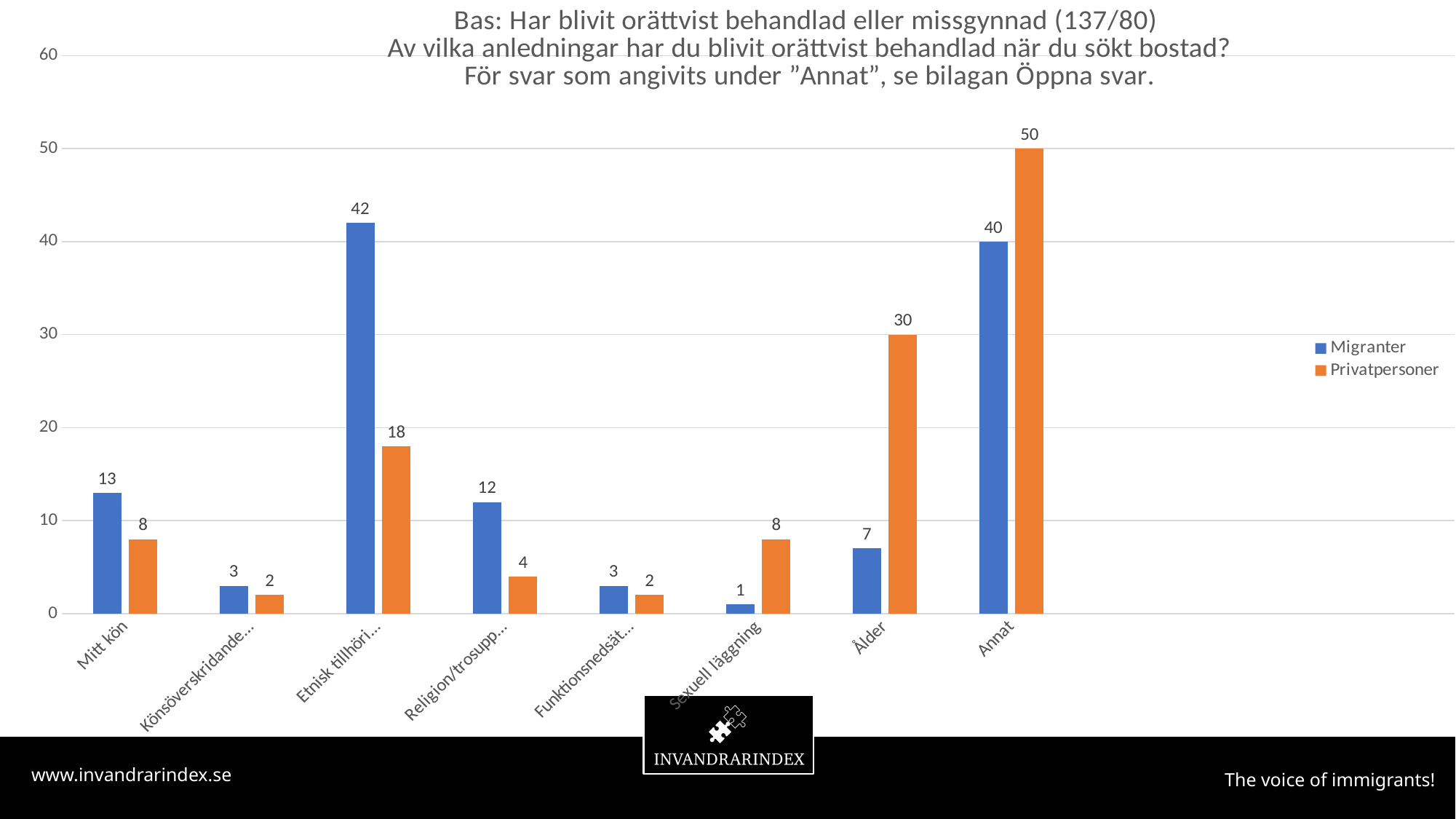
How many categories are shown on the x axis? 8 What is the value for Privatpersoner in the Ålder category? 30 How many series does the legend list? 2 What is the value for Migranter in the Mitt kön category? 13 In the Ålder category, which series has the larger value, Migranter or Privatpersoner? Privatpersoner Is the value for Migranter in the Annat category greater or less than 30? greater Which category has the highest value for Privatpersoner? Annat Which category has the lowest value for Migranter? Sexuell läggning What is the difference between the Privatpersoner and Migranter values in the Annat category? 10 What kind of chart is shown on the slide? Bar chart Which colour represents the Privatpersoner series? Orange What is the value for Privatpersoner in the Sexuell läggning category? 8